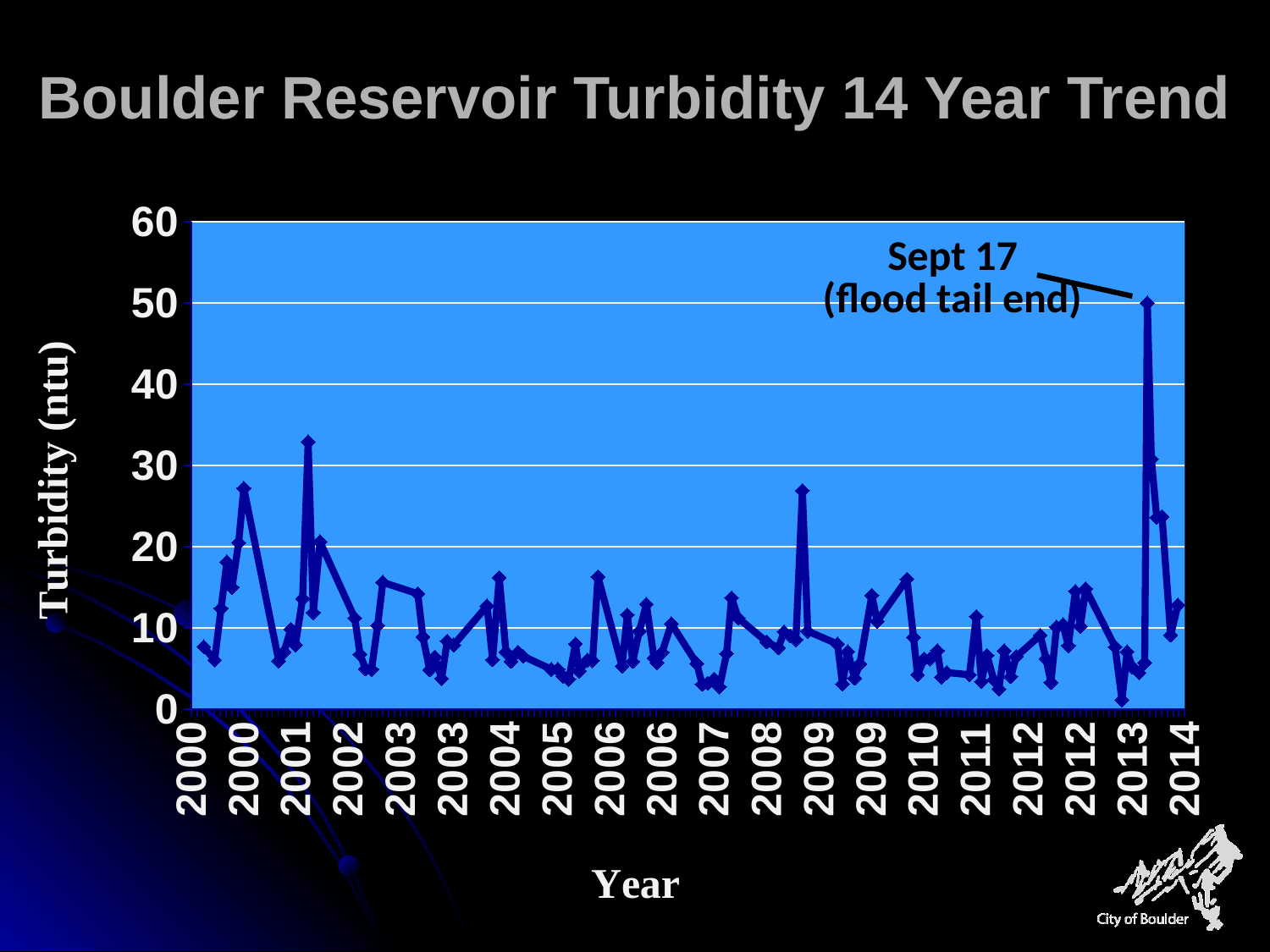
Is the spike in turbidity near the start of 2009 greater or less than 20? greater Is the highest turbidity value in 2000 greater or less than 30? less What kind of chart is shown on the slide? line chart What is the title of the chart? Boulder Reservoir Turbidity 14 Year Trend What is the label of the y axis? Turbidity (ntu) Which is larger: the peak turbidity in 2001 or the peak turbidity in 2000? 2001 Which is larger: the peak turbidity in 2001 or the peak turbidity at the Sept 17 (flood tail end) point? Sept 17 (flood tail end) Which annotated point has the highest turbidity value on the chart? Sept 17 (flood tail end) Is the turbidity value at the Sept 17 (flood tail end) point greater or less than 60? less